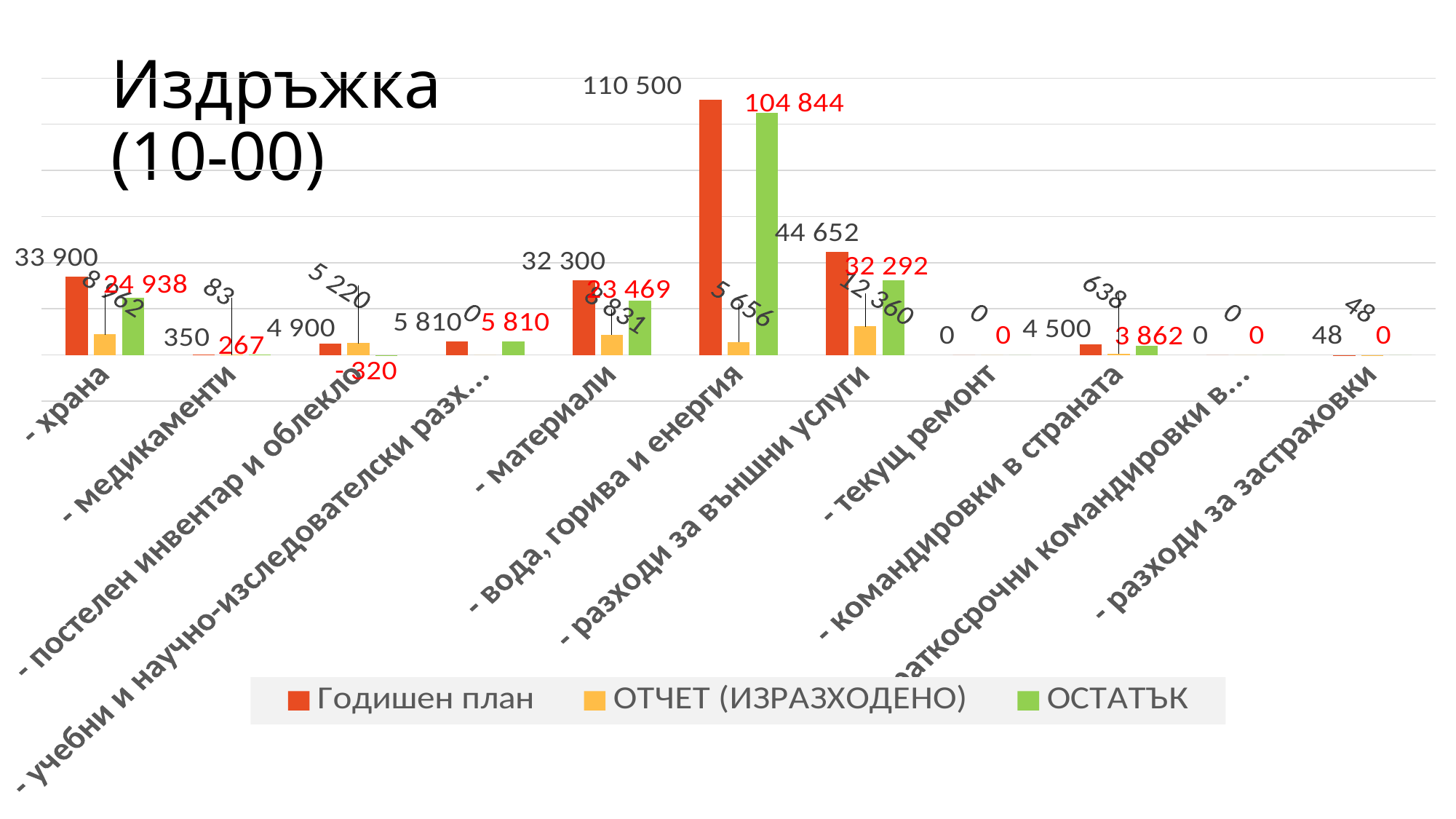
What is the ОСТАТЪК value for храна? 24 938 What kind of chart is shown on the slide? bar chart Which category has the highest Годишен план value? вода, горива и енергия What is the ОТЧЕТ (ИЗРАЗХОДЕНО) value for разходи за външни услуги? 12 360 What is the difference between the Годишен план and ОТЧЕТ (ИЗРАЗХОДЕНО) values for материали? 23 469 Which category has the lowest ОСТАТЪК value? постелен инвентар и облекло What is the Годишен план value for вода, горива и енергия? 110 500 How many categories are shown on the x axis? 11 What is the title of the chart? Издръжка (10-00) Which is larger, the Годишен план value for храна or for материали? храна What is the ОСТАТЪК value for постелен инвентар и облекло? -320 How many series does the legend list? 3